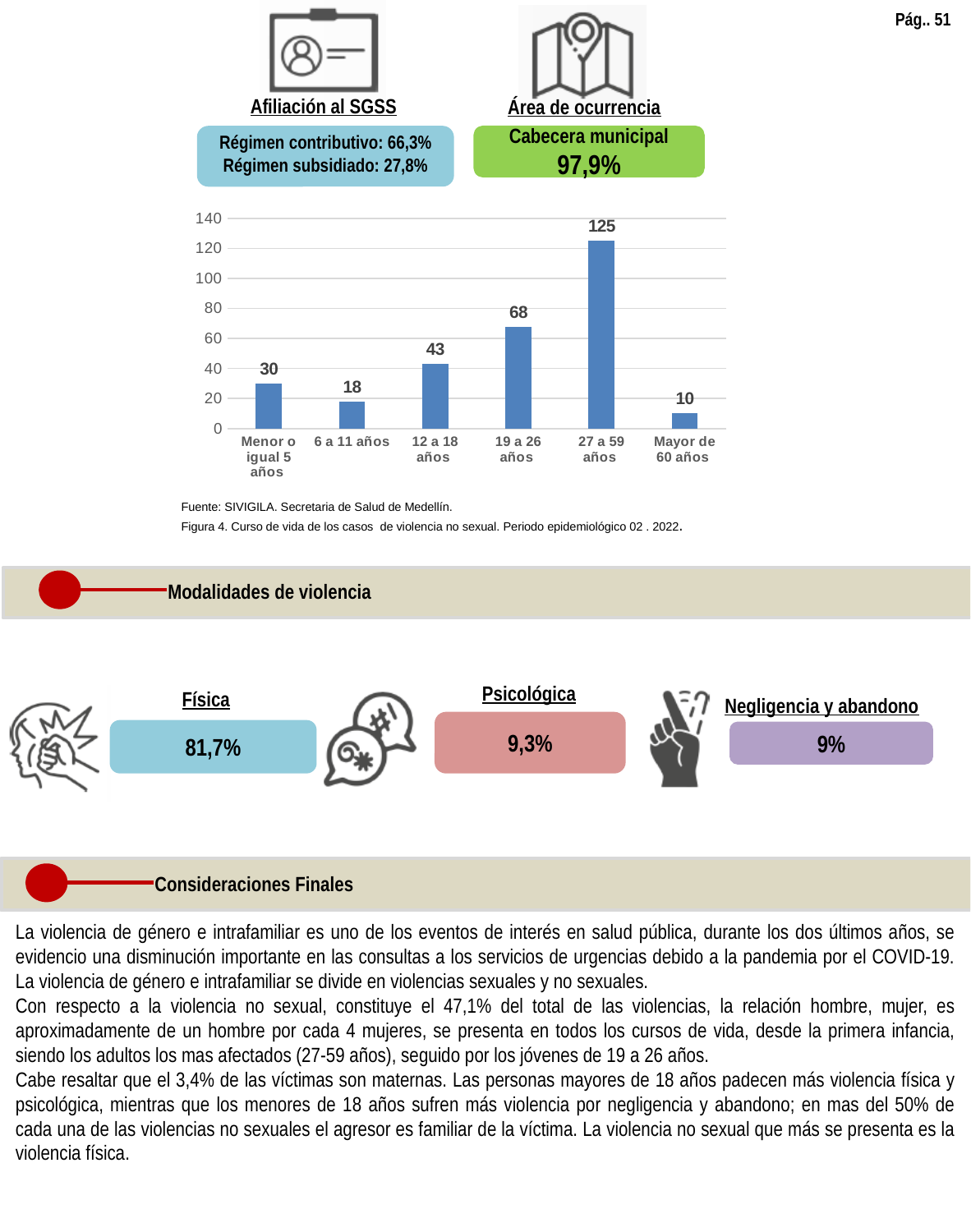
What kind of chart is used to show the cases by age group? Bar chart What is the source cited below the bar chart? SIVIGILA. Secretaria de Salud de Medellín. Is the value for '19 a 26 años' in the bar chart greater or less than 60? greater Which is larger in the bar chart: the value for '12 a 18 años' or the value for 'Menor o igual 5 años'? 12 a 18 años Which age group has the lowest value in the bar chart? Mayor de 60 años What is the value for the 'Menor o igual 5 años' category in the bar chart? 30 What is the value for the '27 a 59 años' category in the bar chart? 125 What is the difference between the values for '27 a 59 años' and '19 a 26 años' in the bar chart? 57 Which age group has the highest value in the bar chart? 27 a 59 años What is the value for the '6 a 11 años' category in the bar chart? 18 What is the total of the values for '6 a 11 años' and '12 a 18 años' in the bar chart? 61 How many age categories are shown in the bar chart? 6